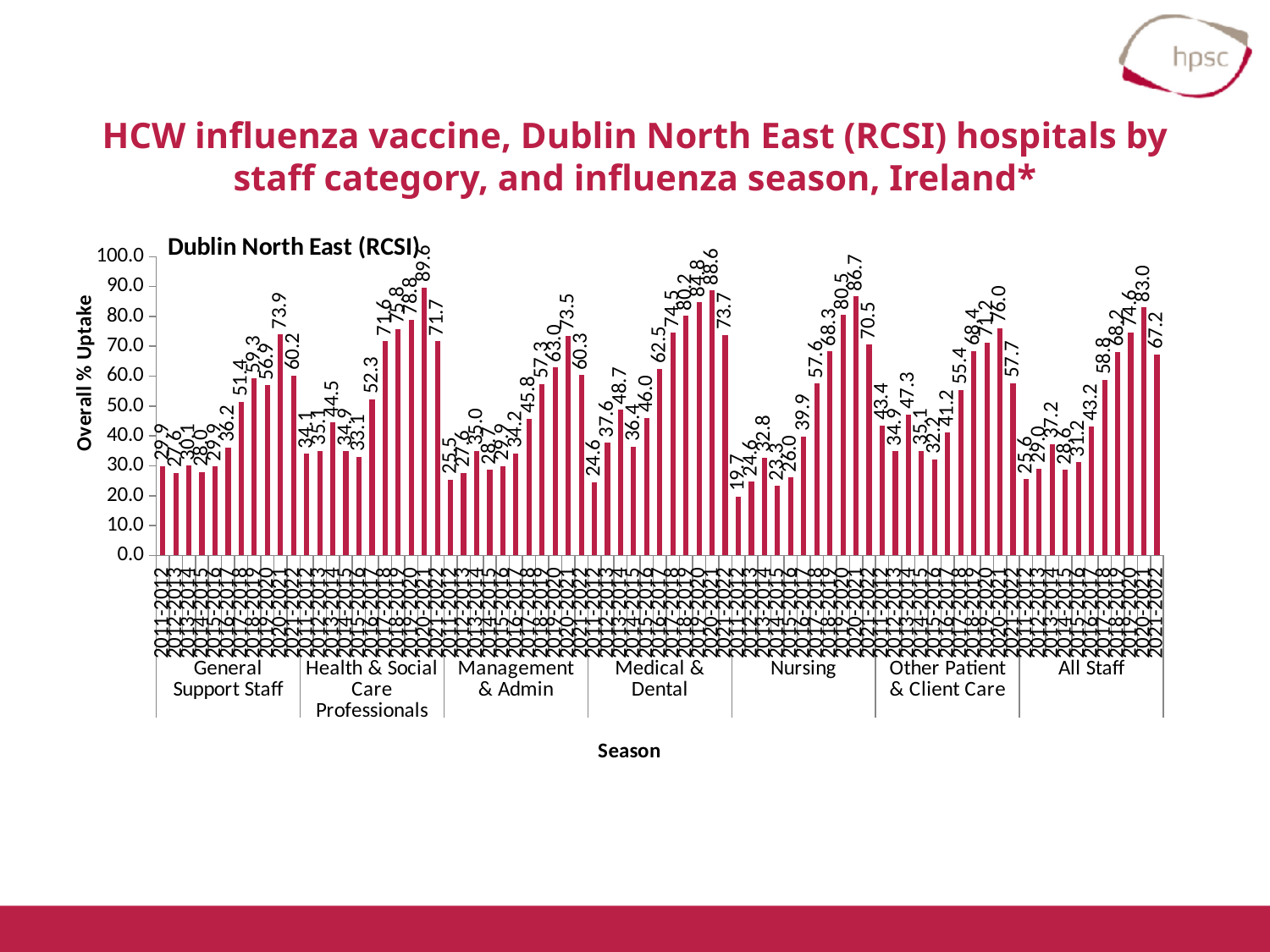
What is the Overall % Uptake for All Staff in the 2021-2022 season? 67.2 What is the Overall % Uptake for All Staff in the 2020-2021 season? 83.0 What is the difference in Overall % Uptake for All Staff between the 2020-2021 and 2021-2022 seasons? 15.8 Which staff category and season has the lowest Overall % Uptake on the chart? Nursing, 2011-2012 What is the Overall % Uptake for Nursing in the 2011-2012 season? 19.7 In the 2020-2021 season, which has the higher Overall % Uptake: Medical & Dental or Nursing? Medical & Dental What kind of chart is shown on the slide? Bar chart What is the title of the y axis of the chart? Overall % Uptake How many staff categories are shown on the x axis of the chart? 7 For All Staff, does the Overall % Uptake rise or fall from the 2016-2017 season to the 2020-2021 season? Rise What is the Overall % Uptake for Health & Social Care Professionals in the 2020-2021 season? 89.6 Which staff category and season has the highest Overall % Uptake on the chart? Health & Social Care Professionals, 2020-2021